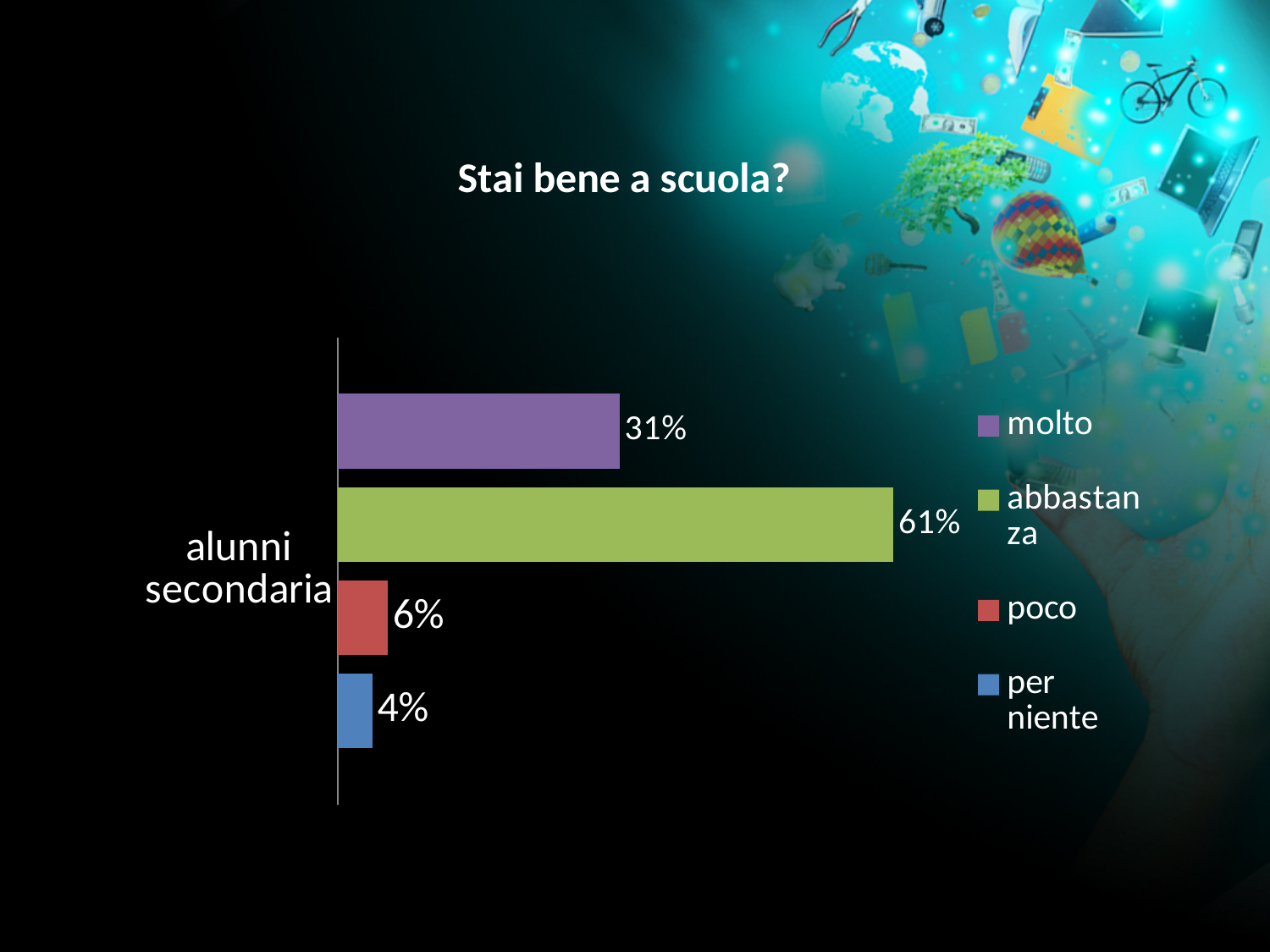
What is the value for "molto"? 31% What is the value for "per niente"? 4% What is the category label shown on the vertical axis? alunni secondaria What kind of chart is shown on the slide? bar chart What is the value for "abbastanza"? 61% Which response has the lowest value? per niente How many series does the legend list? 4 Which response has the highest value? abbastanza What is the value for "poco"? 6% Which is larger, the value for "poco" or the value for "per niente"? poco What is the difference between the values for "abbastanza" and "molto"? 30% What is the title of the chart? Stai bene a scuola?